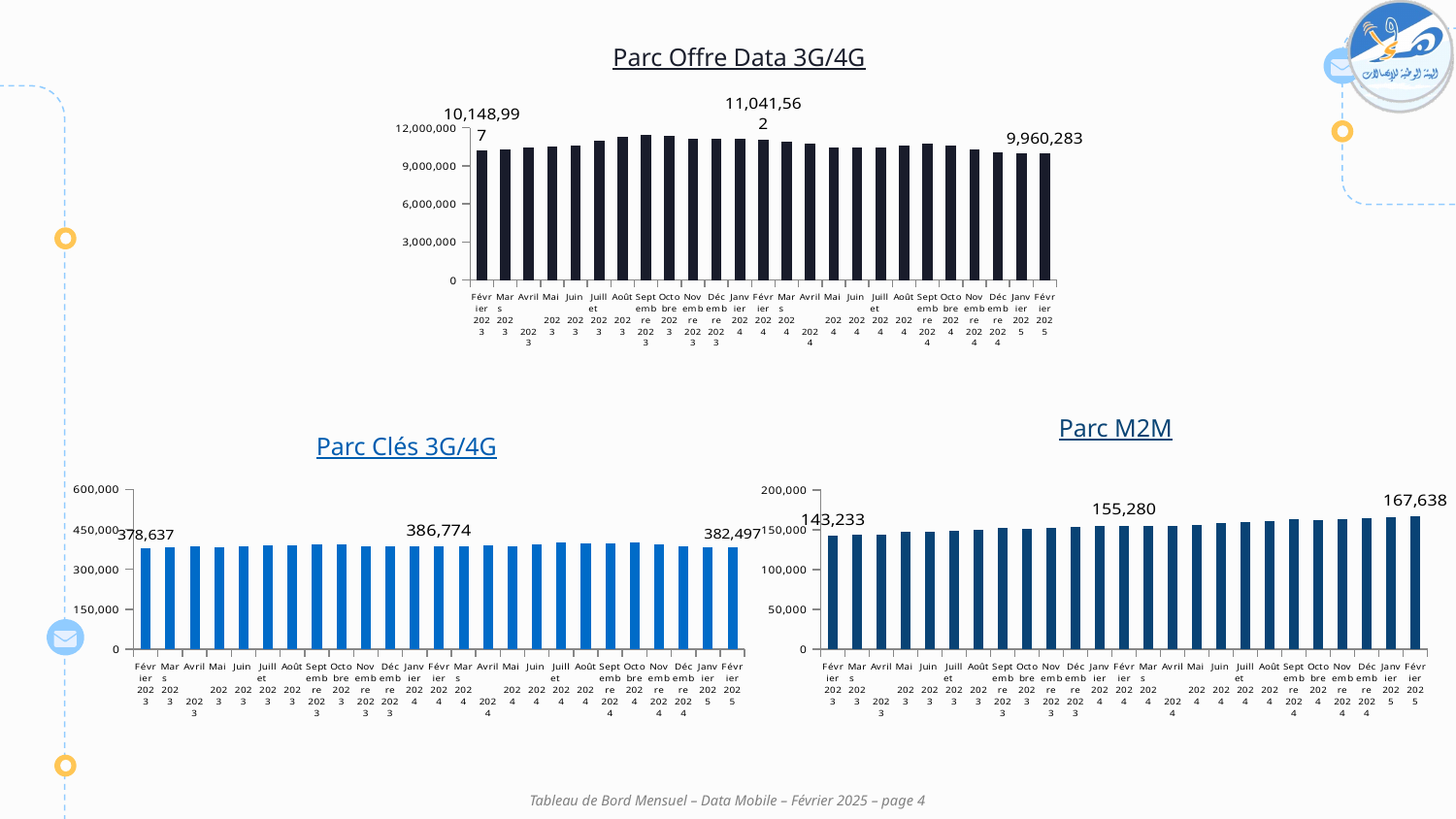
On the Parc Offre Data 3G/4G chart, which is larger, the value for Févr 2023 or the value for Févr 2025? Févr 2023 On the Parc M2M chart, what is the difference between the Févr 2025 value and the Févr 2023 value? 24,405 On the Parc Offre Data 3G/4G chart, what is the difference between the Févr 2023 value and the Févr 2025 value? 188,714 On the Parc Offre Data 3G/4G chart, what is the value for Févr 2025? 9,960,283 On the Parc Clés 3G/4G chart, is the value for Mai 2024 greater or less than 450,000? less On the Parc Clés 3G/4G chart, what is the value for Févr 2023? 378,637 On the Parc M2M chart, what is the value for Févr 2023? 143,233 On the Parc M2M chart, do the values generally rise or fall from Févr 2023 to Févr 2025? rise On the Parc Clés 3G/4G chart, what is the value for Févr 2025? 382,497 On the Parc Offre Data 3G/4G chart, what is the value for Févr 2023? 10,148,997 On the Parc M2M chart, what is the value for Févr 2025? 167,638 On the Parc Offre Data 3G/4G chart, is the value for Juin 2024 greater or less than 9,000,000? greater